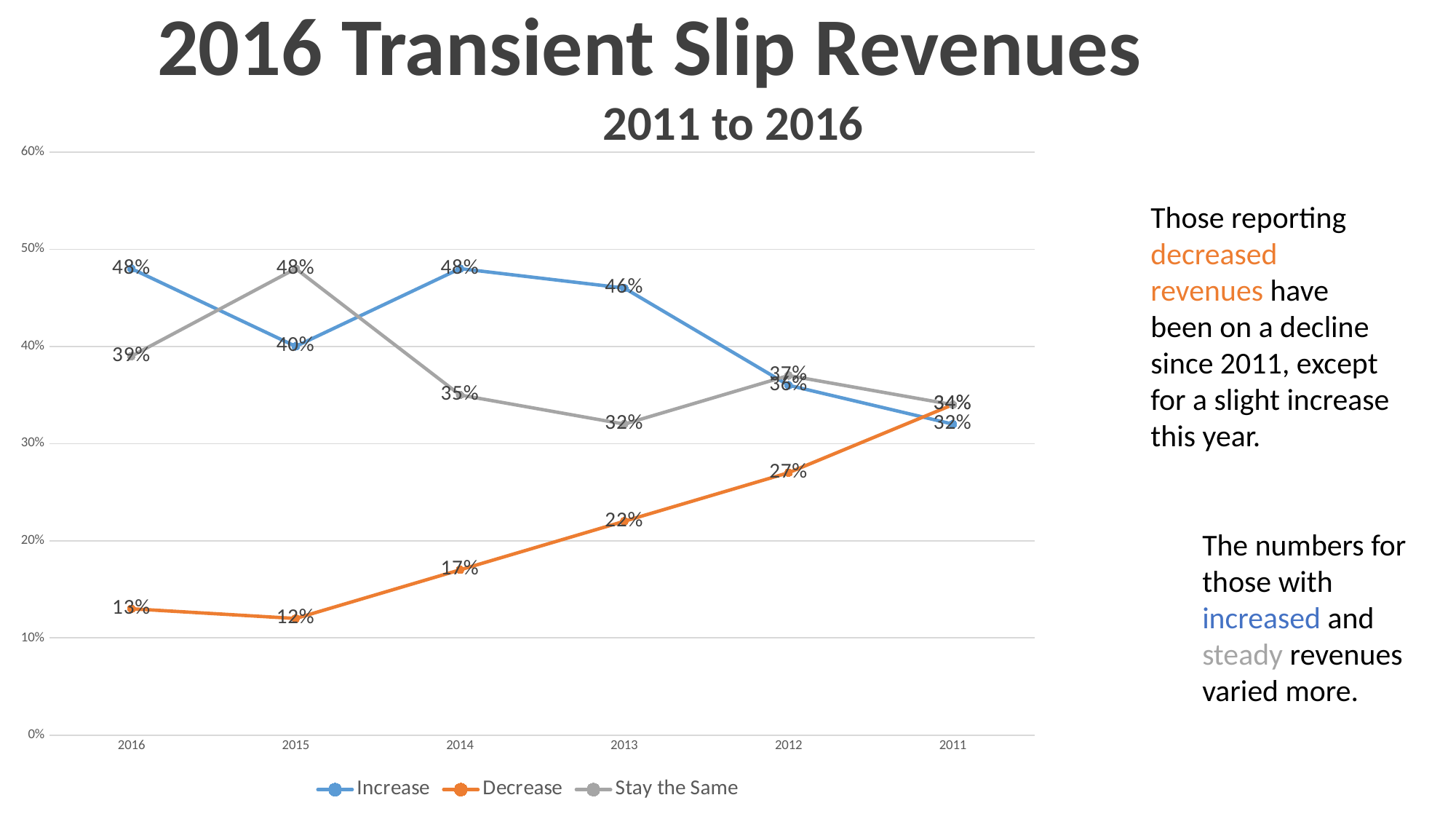
What is the value for Increase in 2015? 40% What is the value for Decrease in 2014? 17% Reading from 2011 on the right to 2016 on the left, does the Decrease series generally rise or fall? fall In which year is the Stay the Same series highest? 2015 What is the value for Stay the Same in 2013? 32% How many series does the legend list? 3 Which is larger in 2014, Increase or Stay the Same? Increase What is the difference between the Increase value and the Decrease value in 2016? 35% What type of chart is shown on the slide? line chart Which series is drawn in orange? Decrease How many years are plotted along the x axis? 6 In which year is the Decrease series lowest? 2015